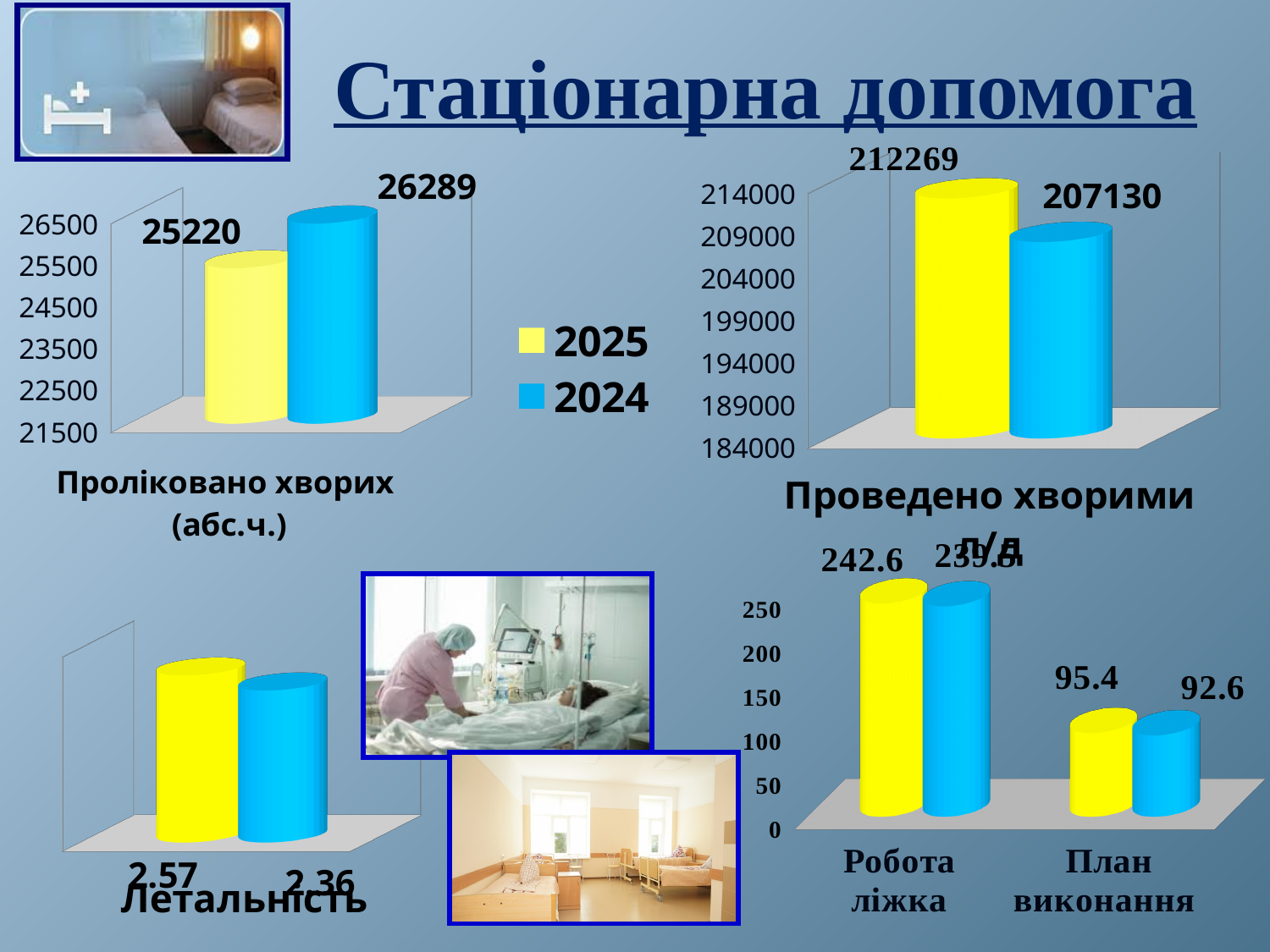
In the 'Летальність' chart, what is the value for 2025 (yellow bar)? 2.57 In the 'Проведено хворими л/д' chart, which year has the higher value? 2025 In the bottom-right chart, what is the 2024 (blue) value for 'План виконання'? 92.6 In the 'Проведено хворими л/д' chart, what is the value for 2025? 212269 In the 'Проліковано хворих (абс.ч.)' chart, what is the value for 2025? 25220 In the 'Проведено хворими л/д' chart, what is the value for 2024? 207130 In the 'Летальність' chart, what is the value for 2024 (blue bar)? 2.36 In the 'Проліковано хворих (абс.ч.)' chart, what is the difference between the 2024 and 2025 values? 1069 In the 'Проліковано хворих (абс.ч.)' chart, what is the value for 2024? 26289 In the 'Проведено хворими л/д' chart, what is the difference between the 2025 and 2024 values? 5139 In the bottom-right chart, what is the 2025 (yellow) value for 'План виконання'? 95.4 Which years does the legend in the middle of the slide list? 2025 and 2024